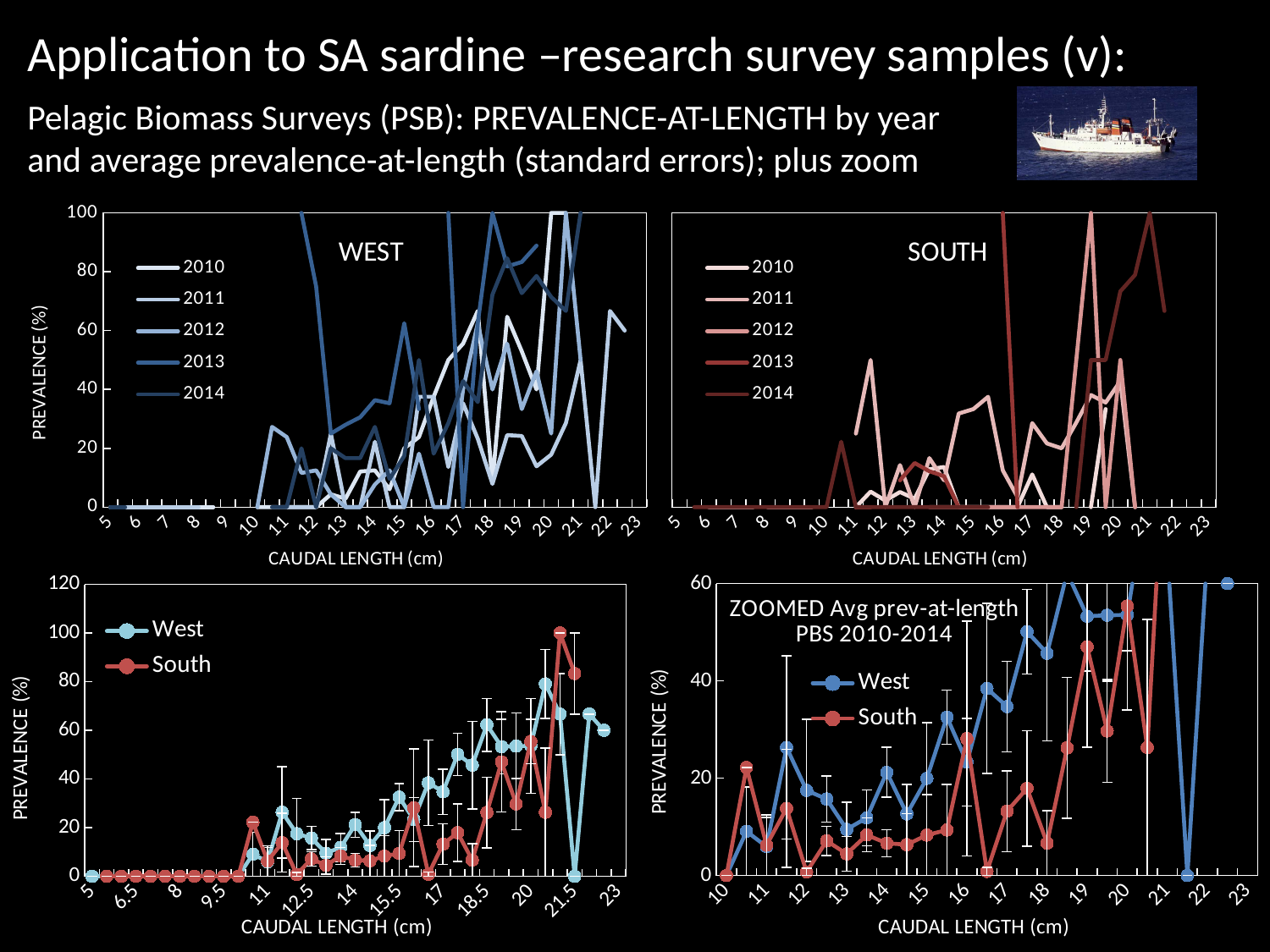
In the bottom-right ZOOMED chart, is the value for West at 18 cm greater or less than 40? greater In the bottom-left chart, is the value for West at 21.5 cm greater or less than 20? less What kind of chart is the top-left WEST chart? line chart In the bottom-left chart, which series is larger at 21.5 cm, West or South? South In the top-left WEST chart, how many series does the legend list? 5 In the top-right SOUTH chart, which years are listed in the legend? 2010, 2011, 2012, 2013, 2014 In the bottom-right ZOOMED chart, is the value for West at 21.5 cm greater or less than 20? less In the bottom-left chart, do the West values generally rise or fall between 10 cm and 20 cm? rise In the bottom-left chart, what is the label on the y axis? PREVALENCE (%) In the bottom-left chart, how many series does the legend list? 2